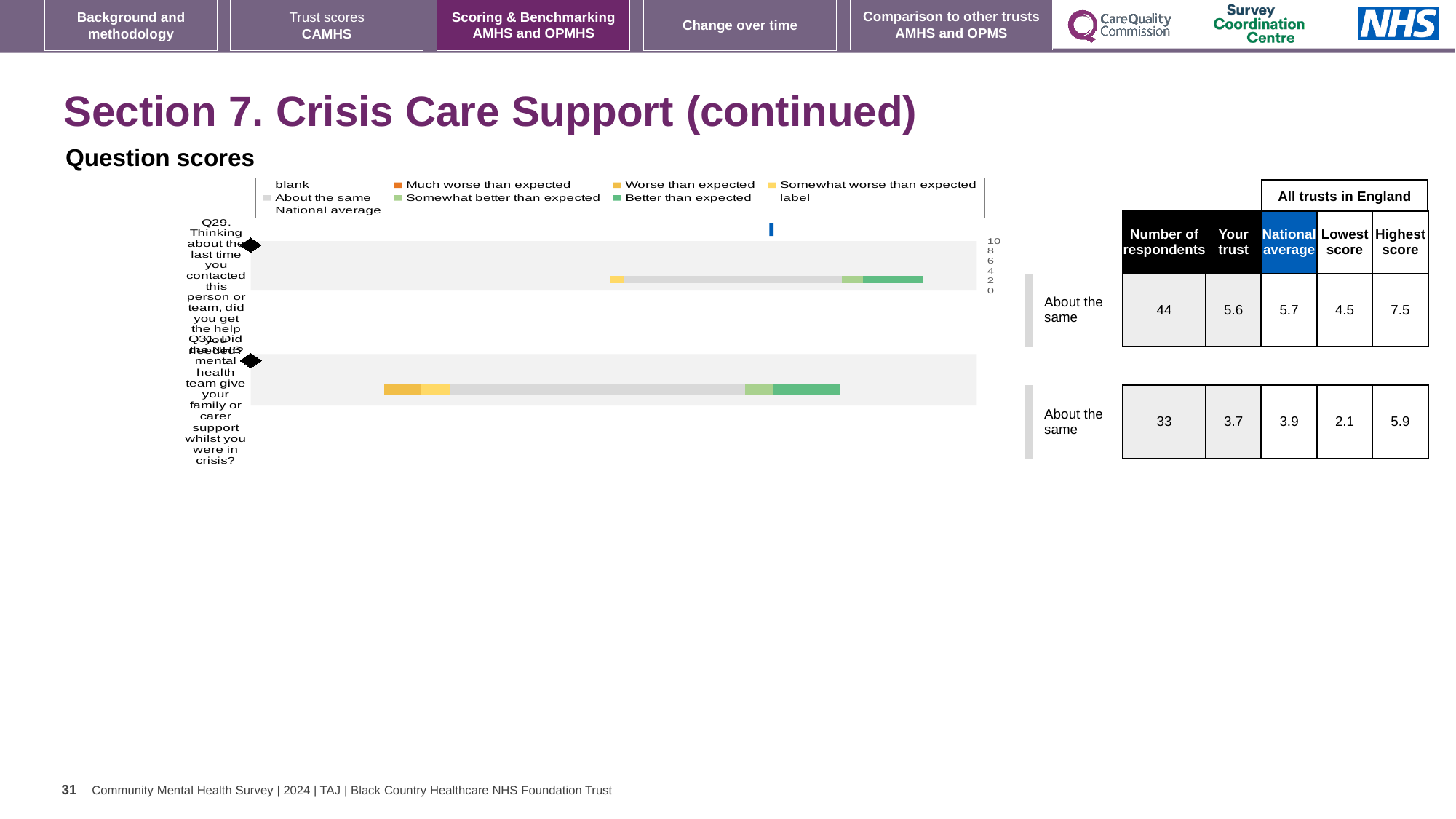
In the table beside the chart, what is the 'Your trust' score for Q29? 5.6 What is the difference between the highest score and the lowest score for Q31? 3.8 For Q29, which is larger: the 'Your trust' score or the national average? National average How many questions (categories) are plotted in the question scores chart? 2 How many entries does the legend of the question scores chart list? 9 In the table beside the chart, what is the national average for Q31? 3.9 What kind of chart is used to show the question scores? bar chart Which question has the higher 'Your trust' score, Q29 or Q31? Q29 In the table beside the chart, how many respondents answered Q29? 44 What is the difference between the highest score and the lowest score for Q29? 3.0 In the legend of the question scores chart, what colour represents 'Better than expected'? green In the table beside the chart, what is the highest score for Q31? 5.9